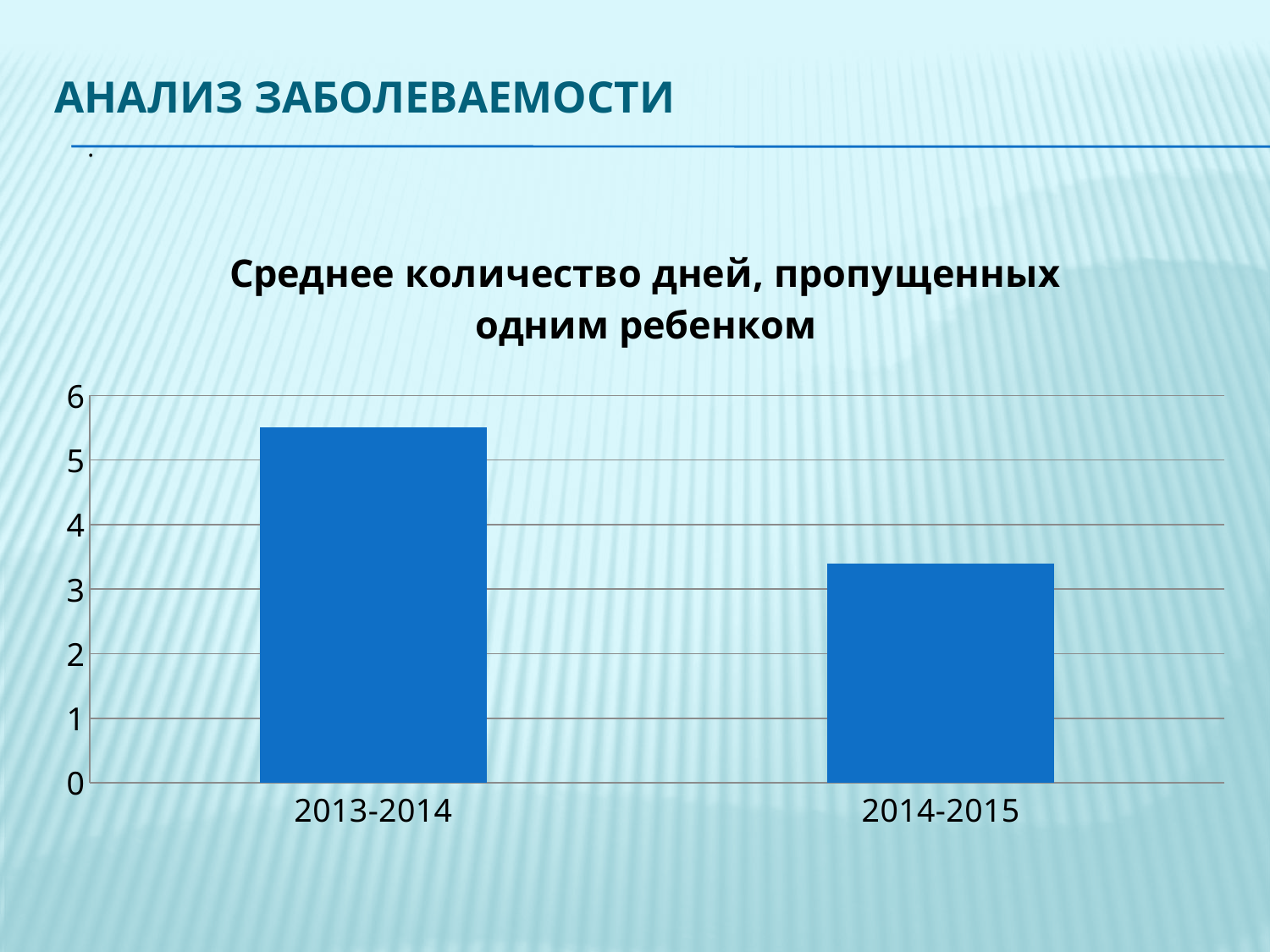
Which is larger, the value for 2013-2014 or the value for 2014-2015? 2013-2014 What is the highest value shown on the vertical axis? 6 Is the value for 2014-2015 greater or less than 4? less Which category has the lowest value? 2014-2015 What kind of chart is shown on the slide? bar chart Do the values rise or fall from 2013-2014 to 2014-2015? fall How many categories are plotted on the chart? 2 What is the title of the chart? Среднее количество дней, пропущенных одним ребенком Is the value for 2013-2014 greater or less than 6? less Is the value for 2014-2015 greater or less than 3? greater Which category has the highest value? 2013-2014